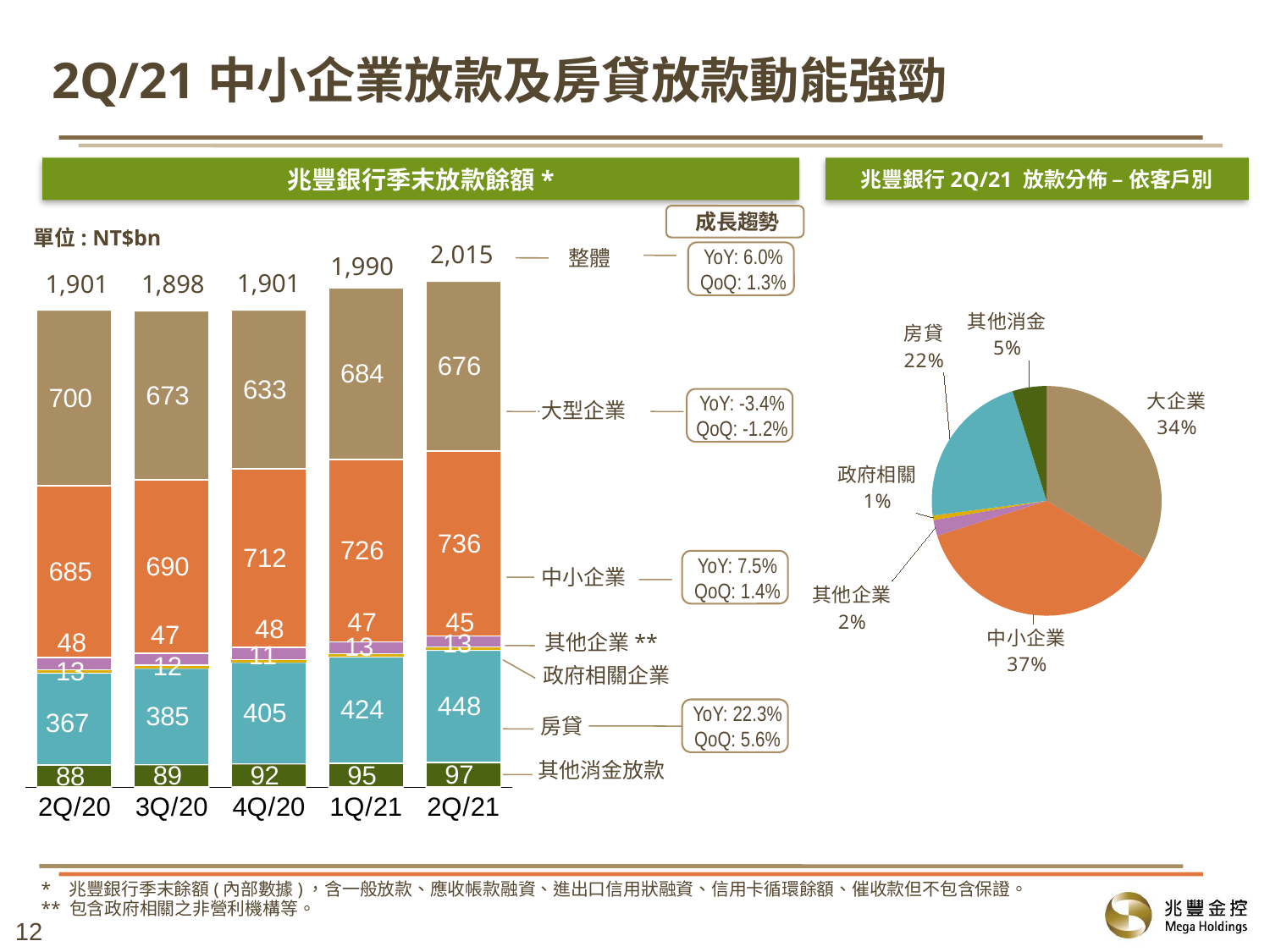
In the stacked bar chart 兆豐銀行季末放款餘額, what is the 房貸 value for 2Q/20? 367 In the stacked bar chart 兆豐銀行季末放款餘額, what is the 中小企業 value for 4Q/20? 712 What kind of chart is 兆豐銀行 2Q/21 放款分佈 – 依客戶別? pie chart In the stacked bar chart 兆豐銀行季末放款餘額, what is the difference between the 大型企業 values for 2Q/20 and 2Q/21? 24 In the stacked bar chart 兆豐銀行季末放款餘額, does the 房貸 value rise or fall from 2Q/20 to 2Q/21? rise In the pie chart 兆豐銀行 2Q/21 放款分佈 – 依客戶別, what share does 房貸 have? 22% In the pie chart 兆豐銀行 2Q/21 放款分佈 – 依客戶別, which category has the largest share? 中小企業 In the stacked bar chart 兆豐銀行季末放款餘額, what is the total loan balance for 2Q/21? 2,015 In the stacked bar chart 兆豐銀行季末放款餘額, is the 中小企業 value larger in 1Q/21 or in 2Q/21? 2Q/21 In the stacked bar chart 兆豐銀行季末放款餘額, which quarter has the highest total loan balance? 2Q/21 In the stacked bar chart 兆豐銀行季末放款餘額, how many quarters are shown on the x axis? 5 In the stacked bar chart 兆豐銀行季末放款餘額, which quarter has the lowest total loan balance? 3Q/20